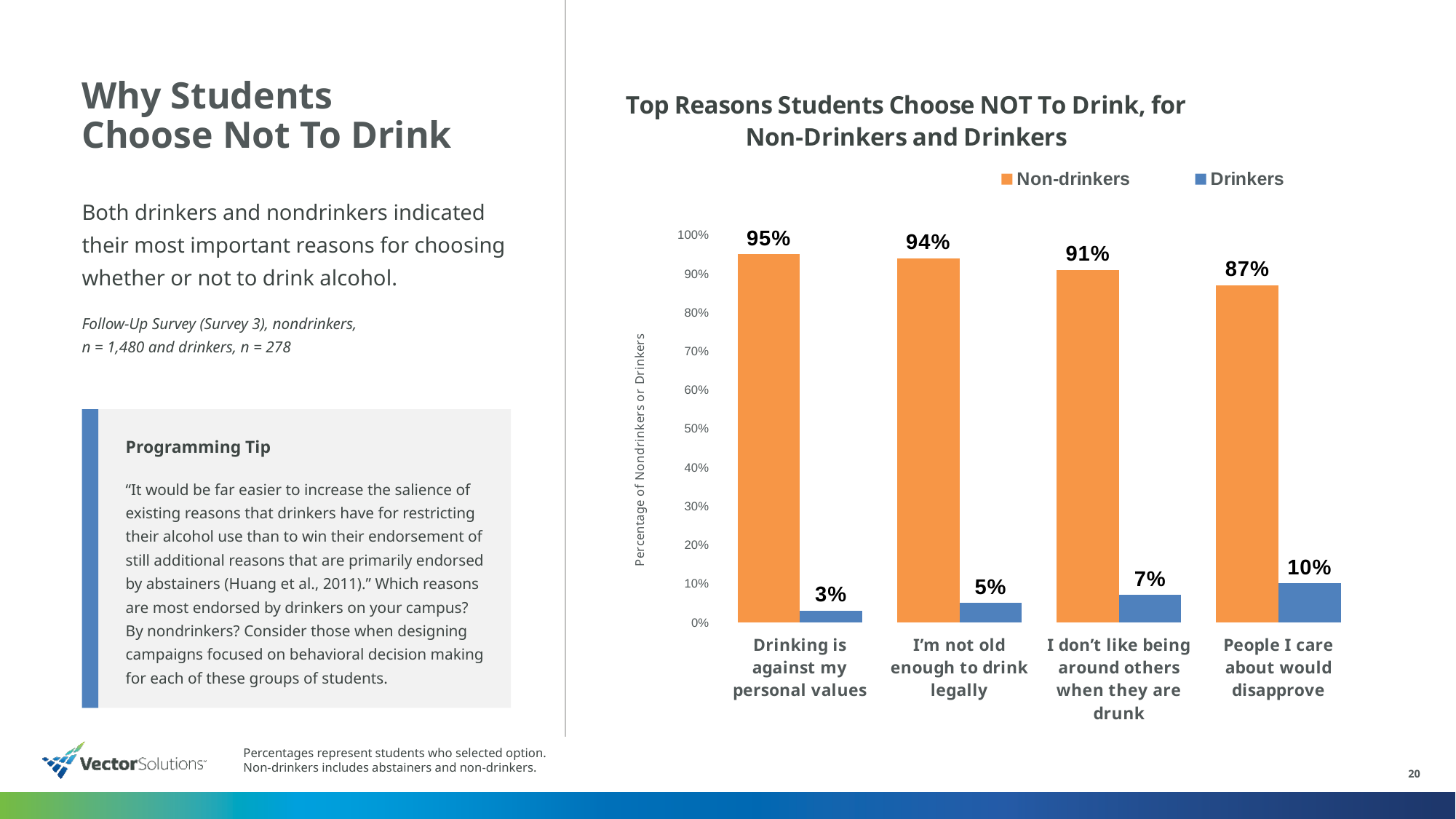
How many series does the legend list? 2 Which reason has the lowest percentage among drinkers? Drinking is against my personal values What percentage of drinkers selected "I'm not old enough to drink legally"? 5% What kind of chart is shown on the slide? Bar chart What is the difference between the non-drinkers and drinkers percentages for "I don't like being around others when they are drunk"? 84 percentage points Is the non-drinkers value for "People I care about would disapprove" greater or less than 80%? greater What percentage of non-drinkers selected "Drinking is against my personal values"? 95% Do the non-drinkers values rise or fall moving left to right across the categories? Fall Which is larger: the non-drinkers value for "People I care about would disapprove" or the non-drinkers value for "I'm not old enough to drink legally"? I'm not old enough to drink legally How many reasons (categories) are shown on the x axis? 4 Which reason has the highest percentage among non-drinkers? Drinking is against my personal values What percentage of drinkers selected "People I care about would disapprove"? 10%